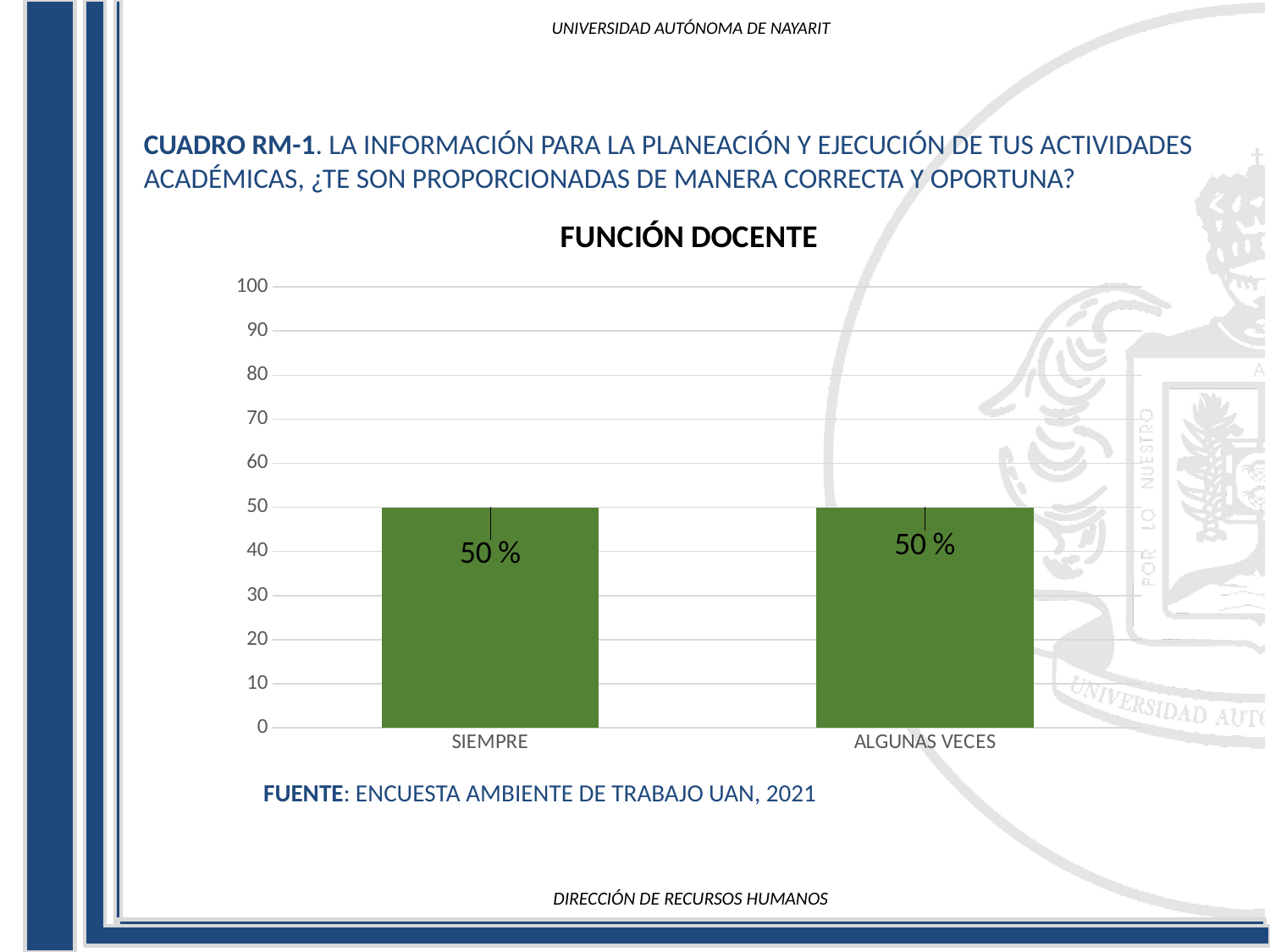
What is the value for ALGUNAS VECES? 50 % Is the value for SIEMPRE greater or less than 60? less What is the title of the chart? FUNCIÓN DOCENTE What kind of chart is shown on the slide? bar chart What colour are the bars in the chart? green What is the total of the values for SIEMPRE and ALGUNAS VECES? 100 % What is the difference between the values for SIEMPRE and ALGUNAS VECES? 0 How many categories are shown on the x axis? 2 What is the value for SIEMPRE? 50 % Is the value for ALGUNAS VECES greater or less than 40? greater What is the highest value shown on the y axis? 100